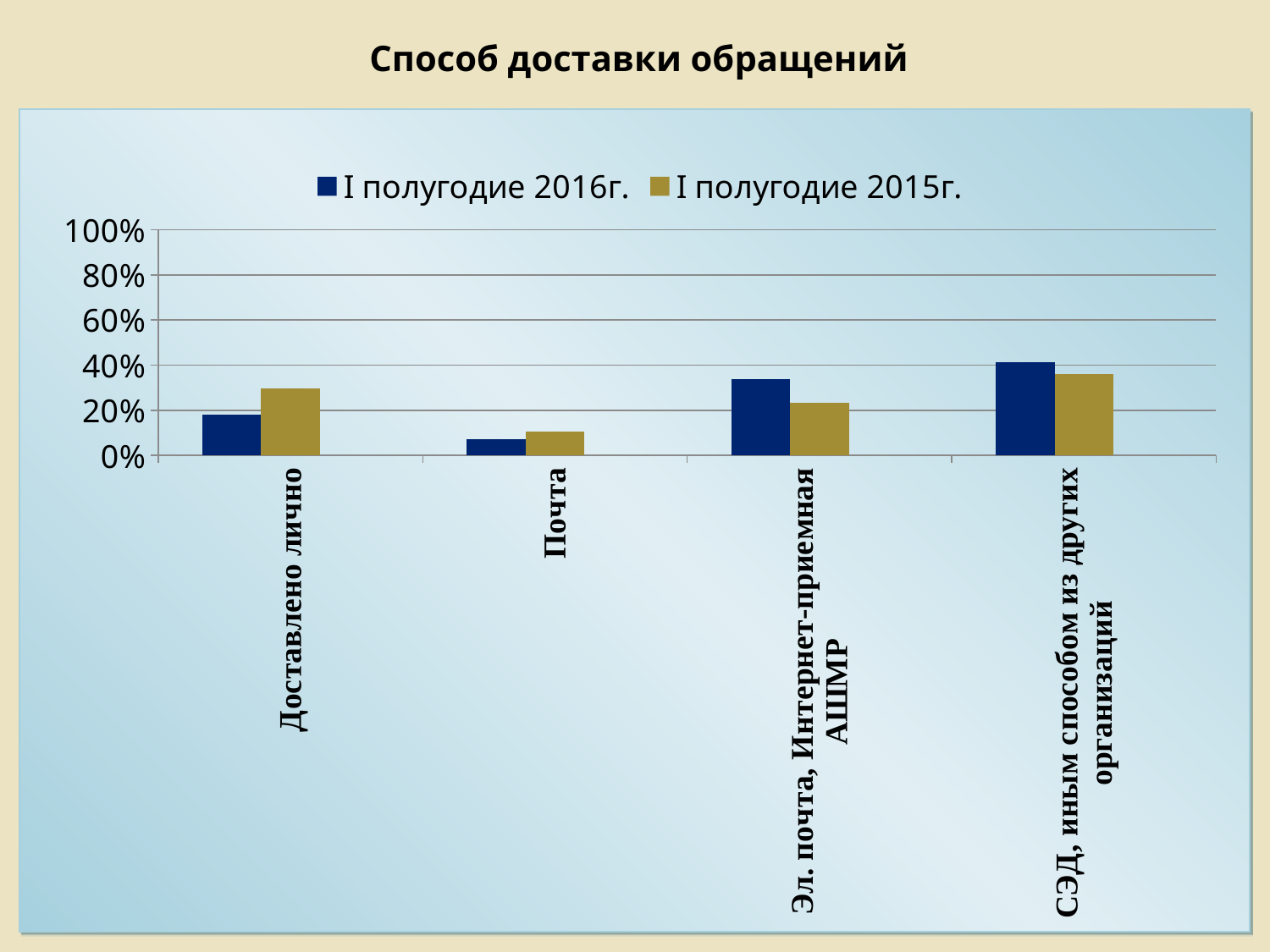
Which category has the lowest value for I полугодие 2016г.? Почта Which category has the lowest value for I полугодие 2015г.? Почта How many categories are shown on the x axis? 4 For Доставлено лично, which series has the larger value: I полугодие 2016г. or I полугодие 2015г.? I полугодие 2015г. What is the title of the slide? Способ доставки обращений What kind of chart is shown on the slide? bar chart For Эл. почта, Интернет-приемная АШМР, which series has the larger value: I полугодие 2016г. or I полугодие 2015г.? I полугодие 2016г. Which series is shown in dark blue in the legend? I полугодие 2016г. Which category has the highest value for I полугодие 2016г.? СЭД, иным способом из других организаций How many series does the legend list? 2 Is the value for I полугодие 2015г. in the category Почта greater or less than 20%? less